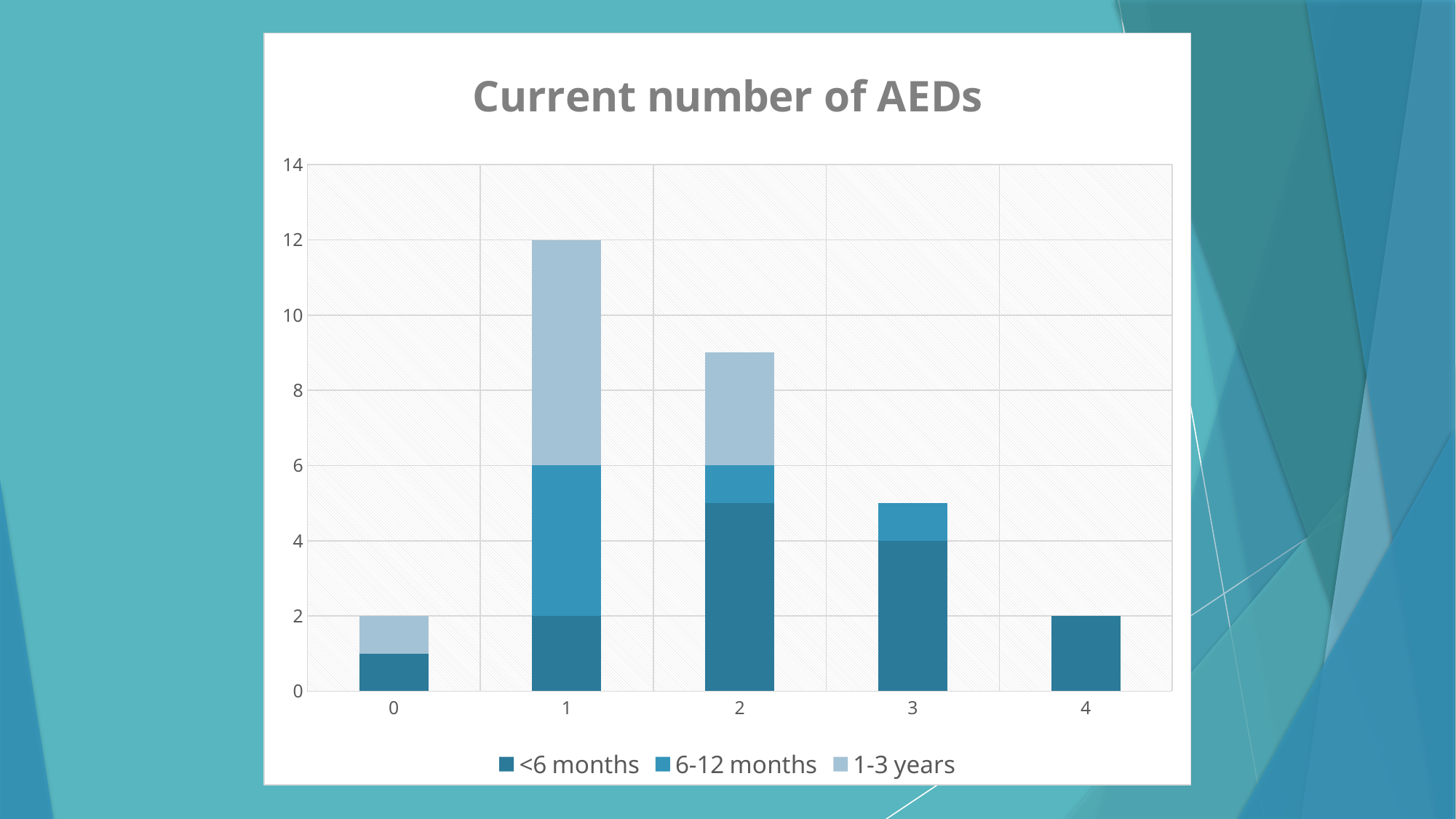
How many categories are shown on the x axis? 5 Is the total for category 2 greater or less than 8? greater What is the total height of the stacked bar for category 1? 12 What is the difference between the total for category 1 and the total for category 4? 10 What kind of chart is shown on the slide? stacked bar chart What is the value of the <6 months segment for category 1? 2 What is the title of the chart? Current number of AEDs Which category has the tallest stacked bar? 1 What is the total height of the stacked bar for category 4? 2 Which has a larger total, category 1 or category 3? 1 How many series does the legend list? 3 What is the value of the <6 months segment for category 3? 4